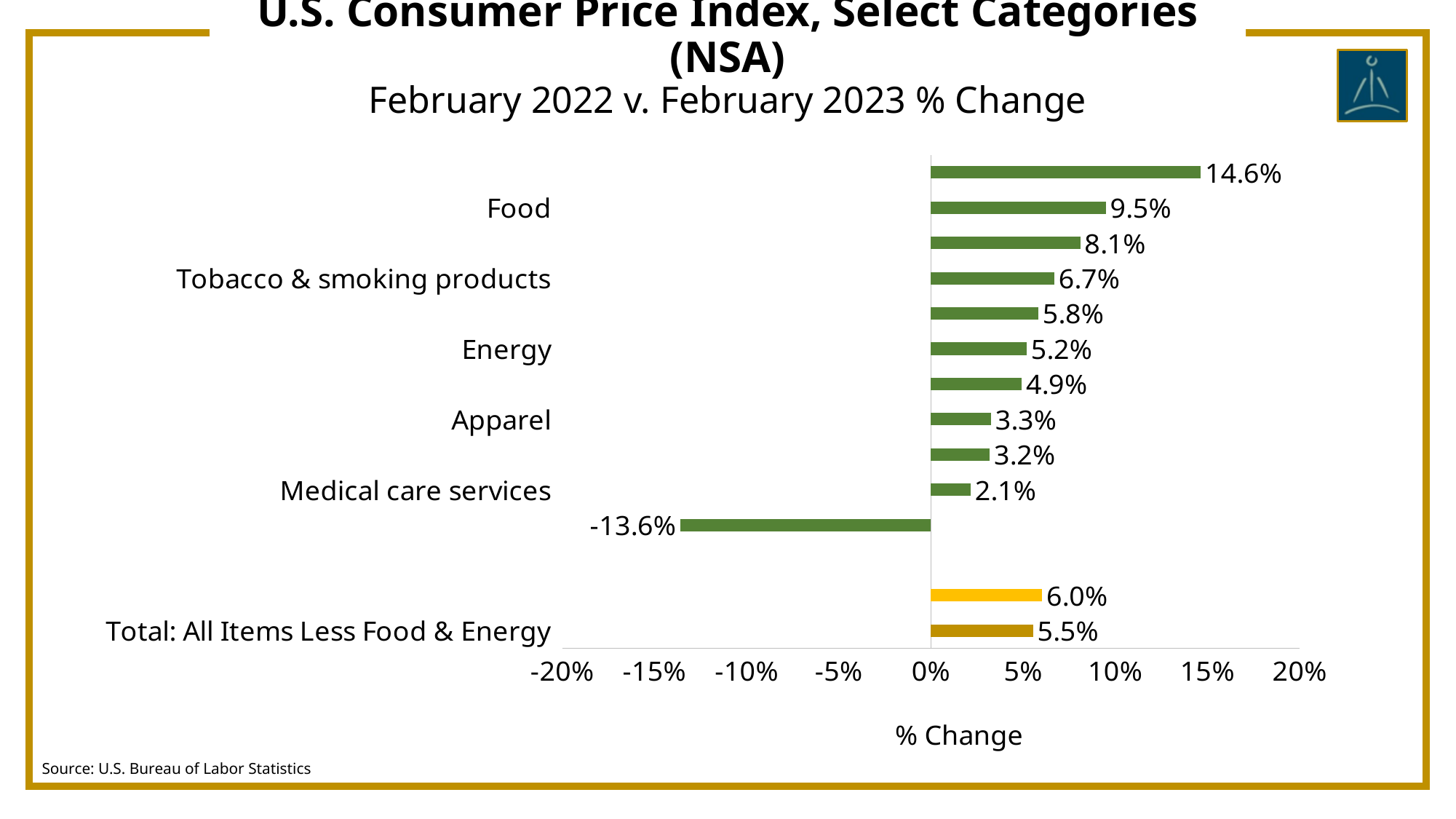
What is the largest value shown on the chart? 14.6% What is the difference between the values for Food and Energy? 4.3 percentage points What is the title of the x axis? % Change What is the value for Energy? 5.2% What is the value for Apparel? 3.3% What is the value for Medical care services? 2.1% Which is larger, the value for Food or the value for Apparel? Food What is the value for Total: All Items Less Food & Energy? 5.5% What is the value for Food? 9.5% What kind of chart is shown on the slide? Bar chart What is the value for Tobacco & smoking products? 6.7% What is the lowest value shown on the chart? -13.6%